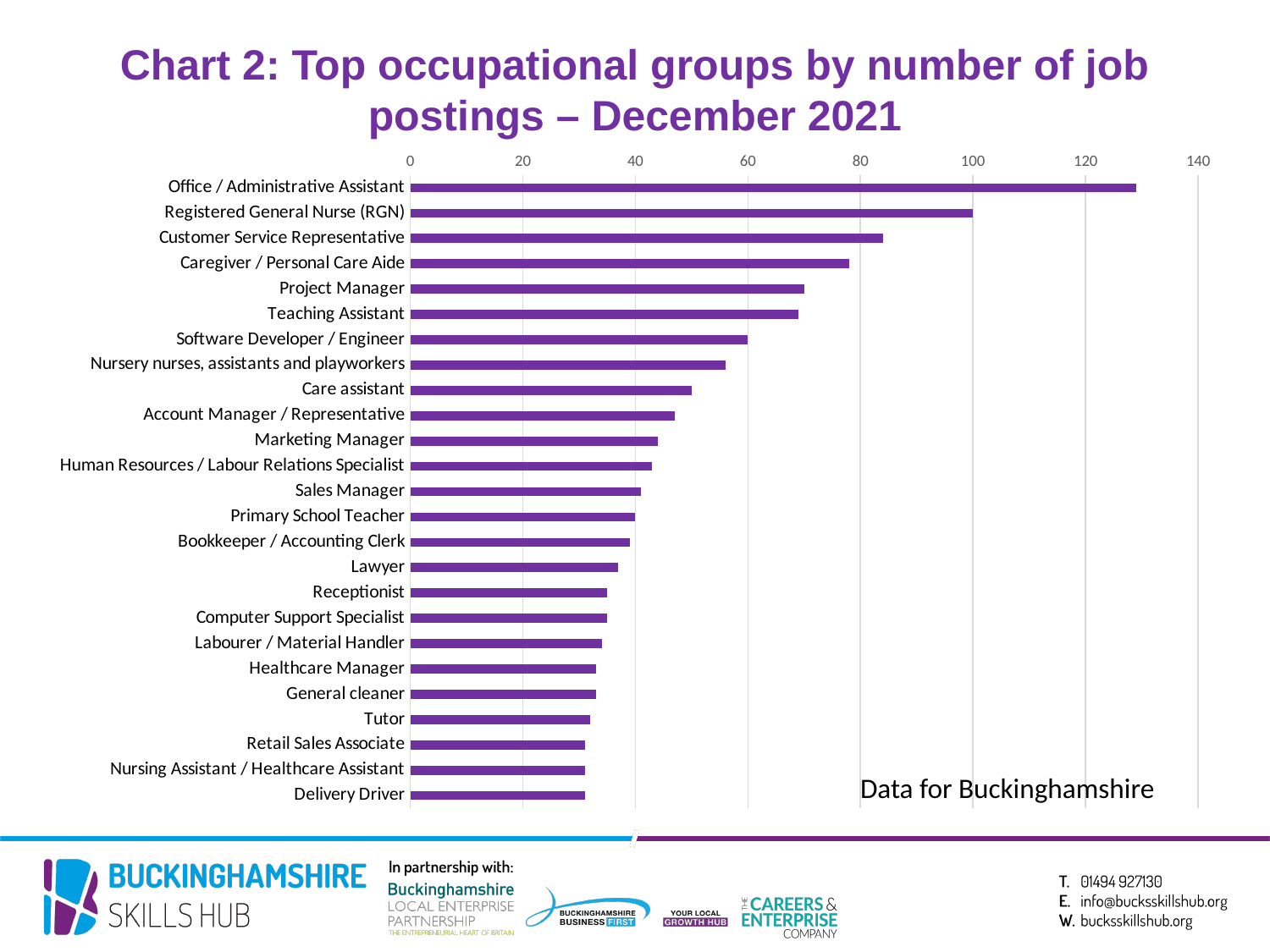
How many occupational groups are listed on the chart? 25 Which has more job postings, Care assistant or Marketing Manager? Care assistant Is the value for Customer Service Representative greater or less than 80? greater Is the value for Lawyer greater or less than 40? less What is the title of the chart? Chart 2: Top occupational groups by number of job postings – December 2021 Is the value for Office / Administrative Assistant greater or less than 120? greater What type of chart is shown on the slide? Bar chart Which occupational group has the highest number of job postings? Office / Administrative Assistant What is the number of job postings for Registered General Nurse (RGN)? 100 Which has more job postings, Customer Service Representative or Caregiver / Personal Care Aide? Customer Service Representative